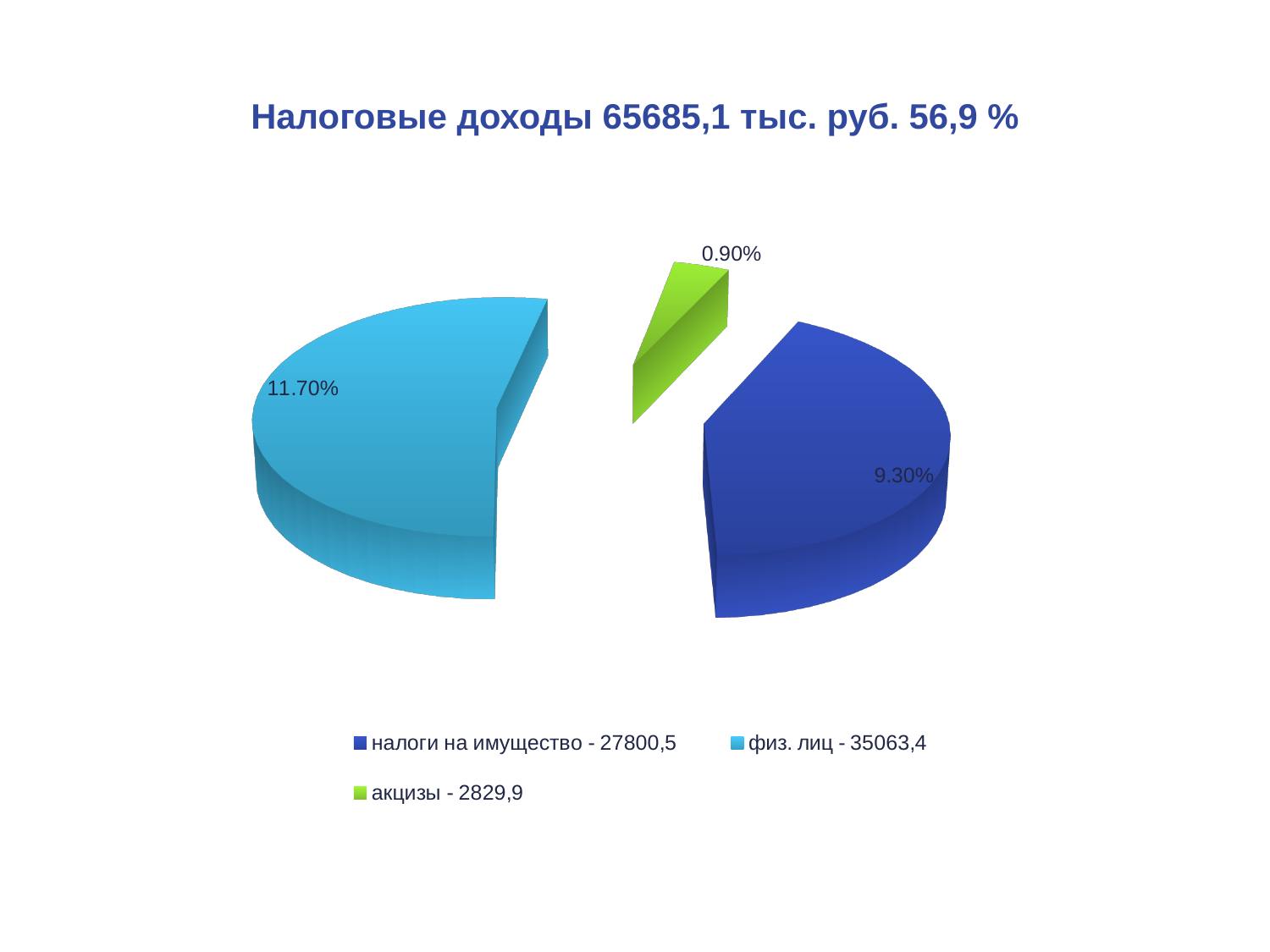
What percentage label is shown on the slice for физ. лиц? 11.70% What is the title of the chart? Налоговые доходы 65685,1 тыс. руб. 56,9 % How many slices does the pie chart have? 3 What colour is the slice for акцизы? green Which is larger: the slice for налоги на имущество or the slice for физ. лиц? физ. лиц What percentage label is shown on the slice for акцизы? 0.90% What kind of chart is shown on the slide? pie chart What percentage label is shown on the slice for налоги на имущество? 9.30% Which slice of the pie chart is the largest? физ. лиц What value is given for акцизы in the legend? 2829,9 What is the difference between the percentage labels for физ. лиц and налоги на имущество? 2.40% Which slice of the pie chart is the smallest? акцизы